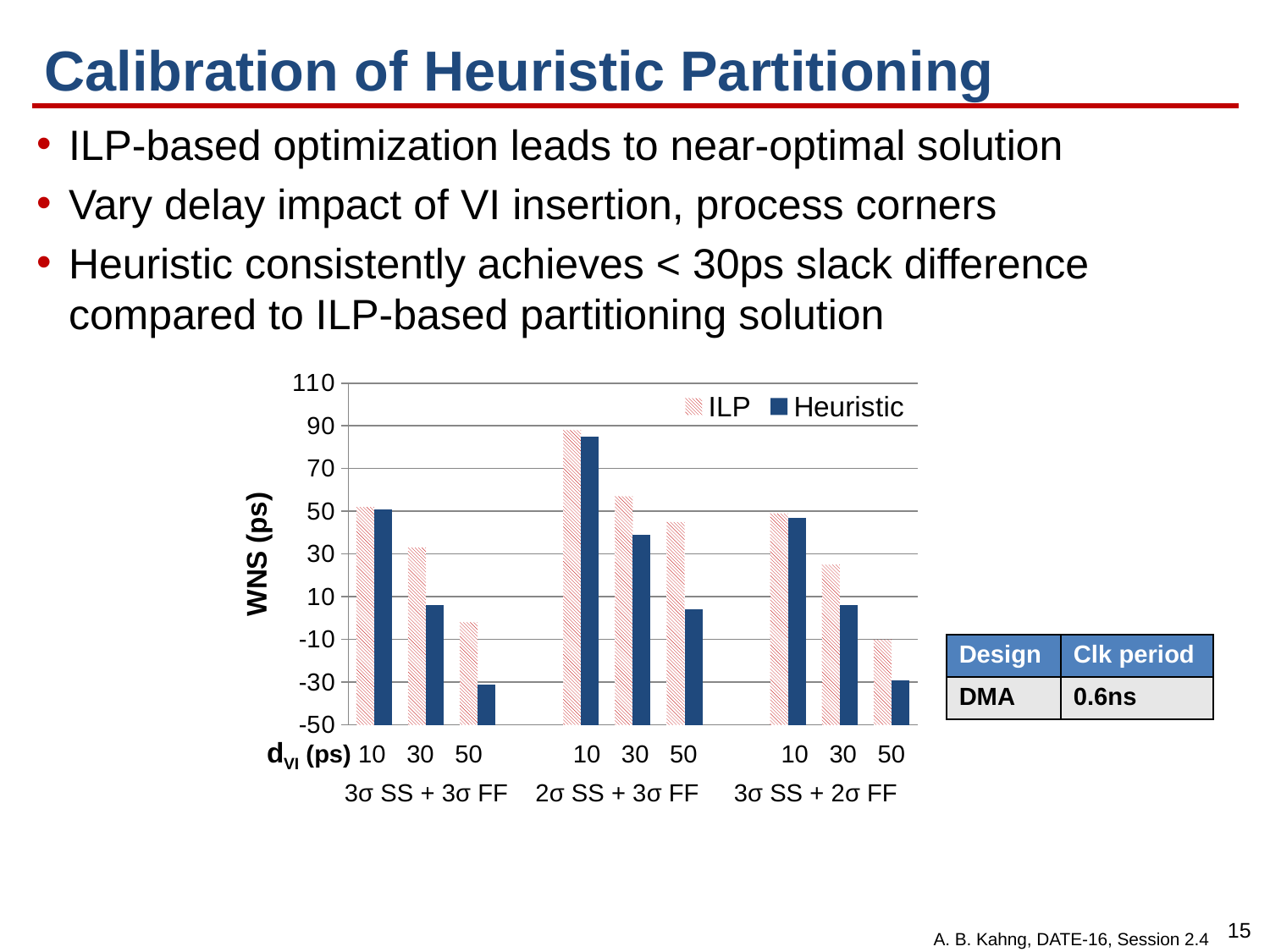
What are the two series named in the chart legend? ILP and Heuristic Which bar in the chart has the highest WNS value? ILP at d_VI = 10 ps in 2σ SS + 3σ FF How many bars are plotted for the Heuristic series in total? 9 How many process-corner groups are shown along the x axis of the chart? 3 Within each process-corner group, does WNS rise or fall as d_VI increases from 10 to 50 ps? fall How many series does the chart legend list? 2 What is the label of the chart's vertical axis? WNS (ps) Is the Heuristic value at d_VI = 30 ps for 2σ SS + 3σ FF greater or less than 30? greater Is the Heuristic value at d_VI = 50 ps for 3σ SS + 3σ FF greater or less than -10? less At d_VI = 30 ps in the 2σ SS + 3σ FF group, which is larger, the ILP value or the Heuristic value? ILP Is the ILP value at d_VI = 10 ps for 2σ SS + 3σ FF greater or less than 70? greater What kind of chart is shown on the slide? bar chart